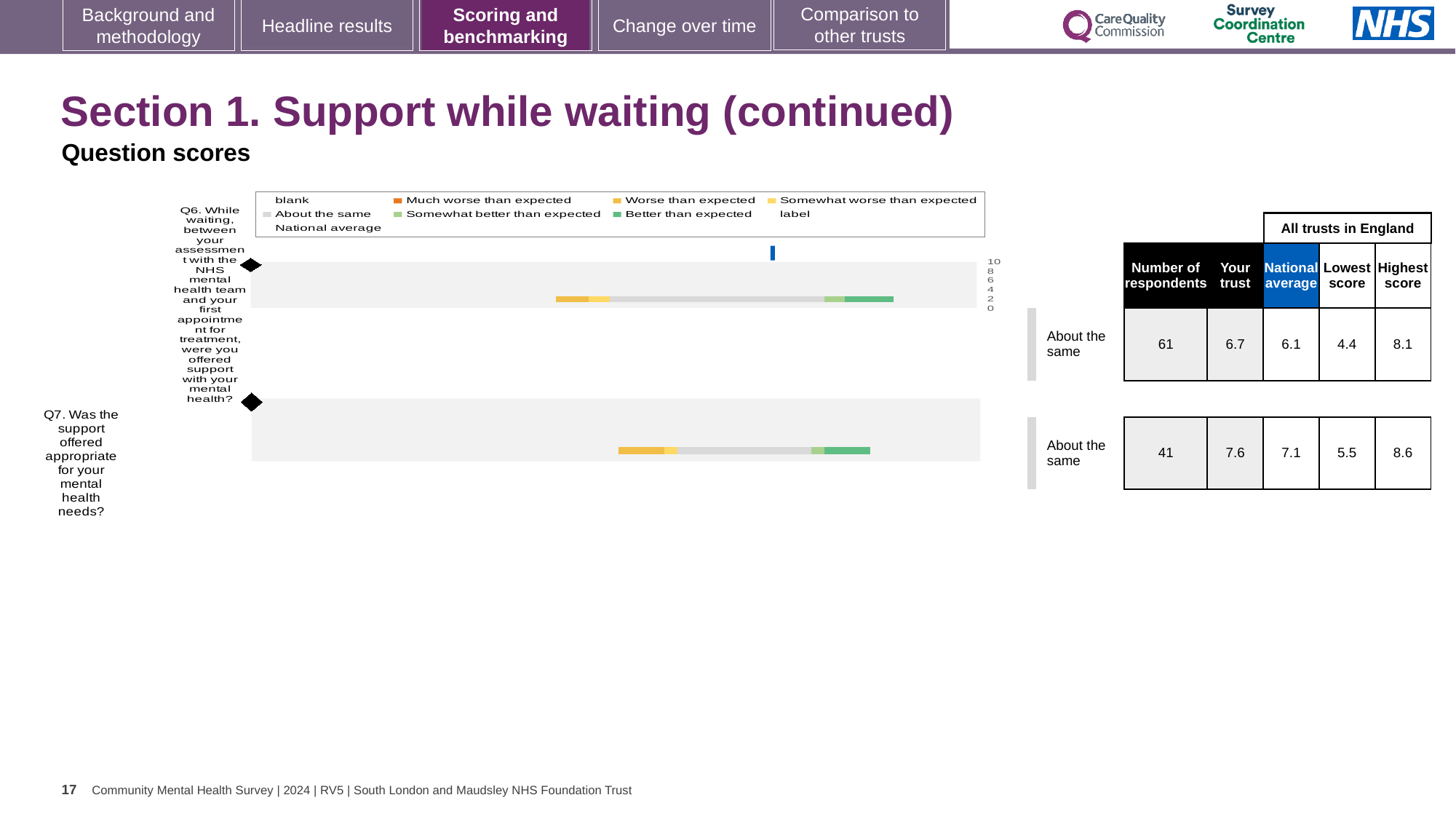
What is the lowest score among all trusts in England for Q6? 4.4 What is the highest score among all trusts in England for Q7? 8.6 What kind of chart is used to show the question scores on this slide? bar chart What is the national average score for Q7 (was the support offered appropriate for your mental health needs)? 7.1 Which legend entry is shown in dark green in the question scores chart? Better than expected How many respondents answered Q6? 61 Which question has the higher 'Your trust' score, Q6 or Q7? Q7 How many questions (categories) are plotted in the question scores chart? 2 What is the difference between the trust's score and the national average for Q6? 0.6 How is the trust's score for Q7 categorised relative to expectations? About the same Which question has the lower number of respondents, Q6 or Q7? Q7 What is the 'Your trust' score for Q6 (support while waiting between assessment and first appointment)? 6.7